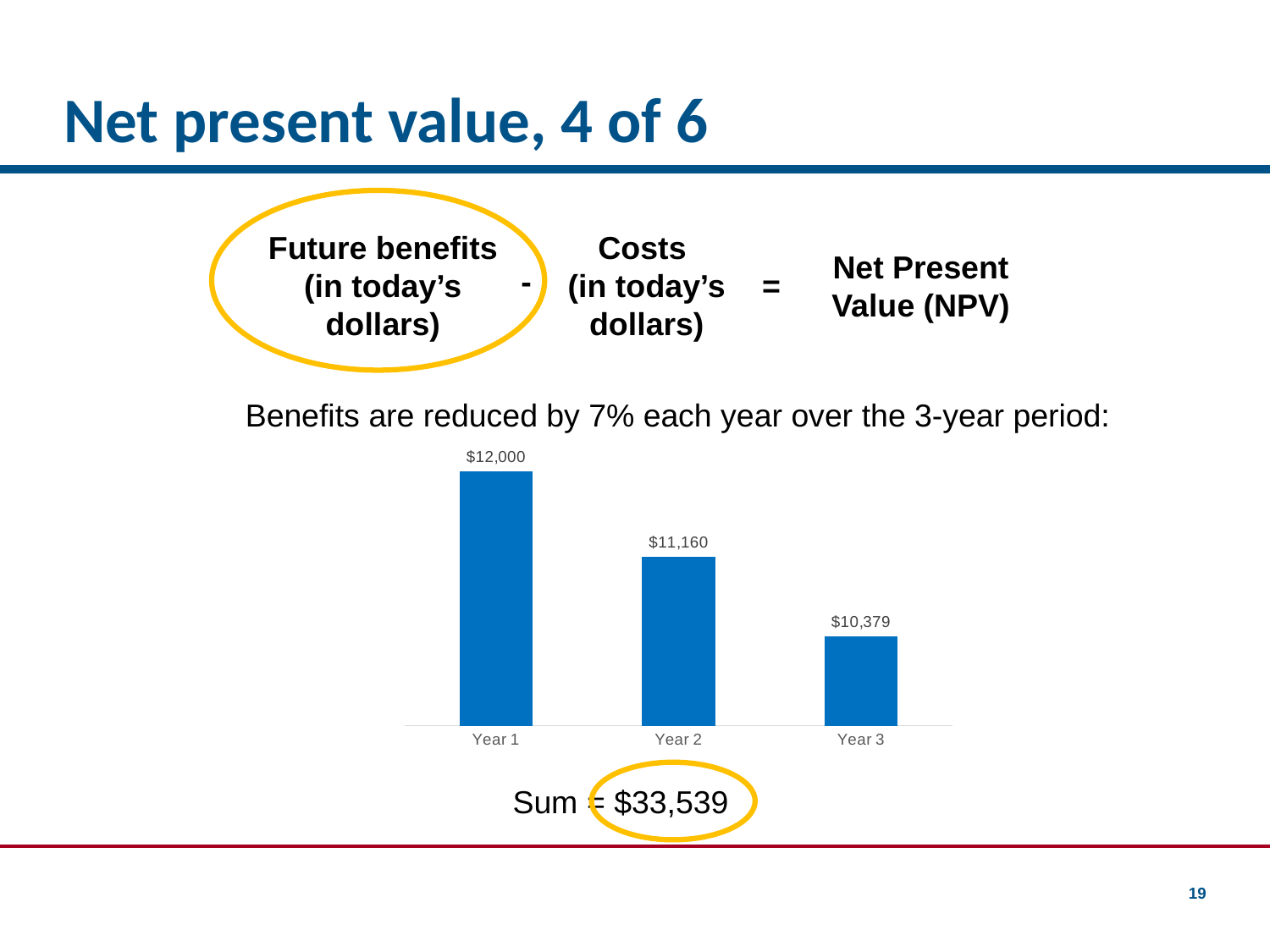
Which year has the highest value? Year 1 Do the values rise or fall from Year 1 to Year 3? Fall What kind of chart is shown on the slide? Bar chart What is the difference between the Year 1 and Year 3 values? $1,621 Which is larger, the value for Year 2 or the value for Year 3? Year 2 What is the value for Year 2? $11,160 How many bars are shown in the chart? 3 What is the value for Year 1? $12,000 Which year has the lowest value? Year 3 What is the difference between the Year 2 and Year 3 values? $781 What is the value for Year 3? $10,379 What is the difference between the Year 1 and Year 2 values? $840